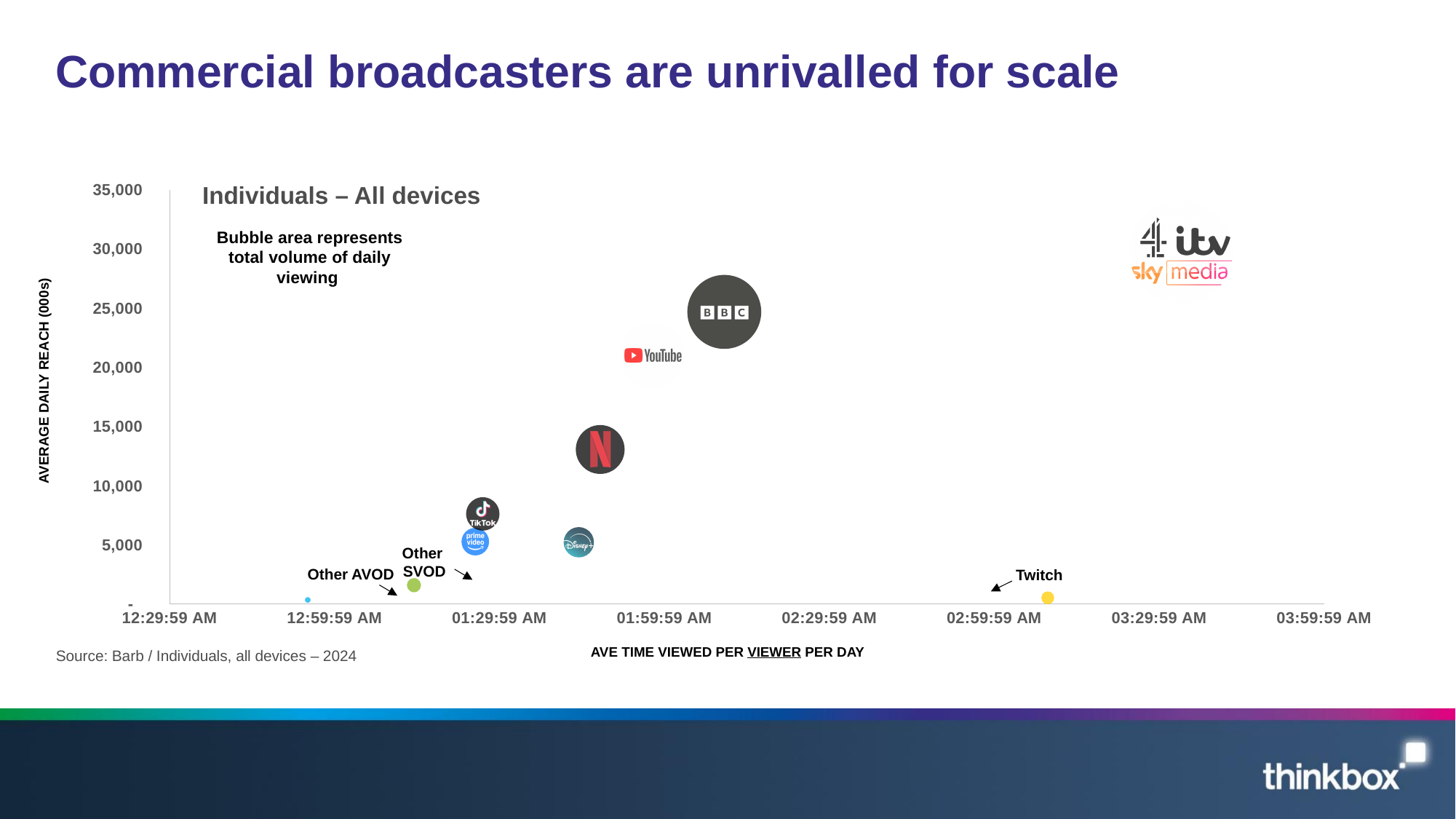
According to the note on the chart, what does the bubble area represent? Total volume of daily viewing Which has the higher average time viewed per viewer per day, Twitch or Netflix? Twitch Is the average daily reach for Disney+ greater or less than 10,000? less Which has the higher average daily reach, BBC or Netflix? BBC Is the average daily reach for Netflix greater or less than 10,000? greater Which has the higher average daily reach, TikTok or Other SVOD? TikTok Is the average daily reach for Twitch greater or less than 5,000? less What kind of chart is shown on the slide? Bubble chart What is the label of the vertical axis of the chart? AVERAGE DAILY REACH (000s)